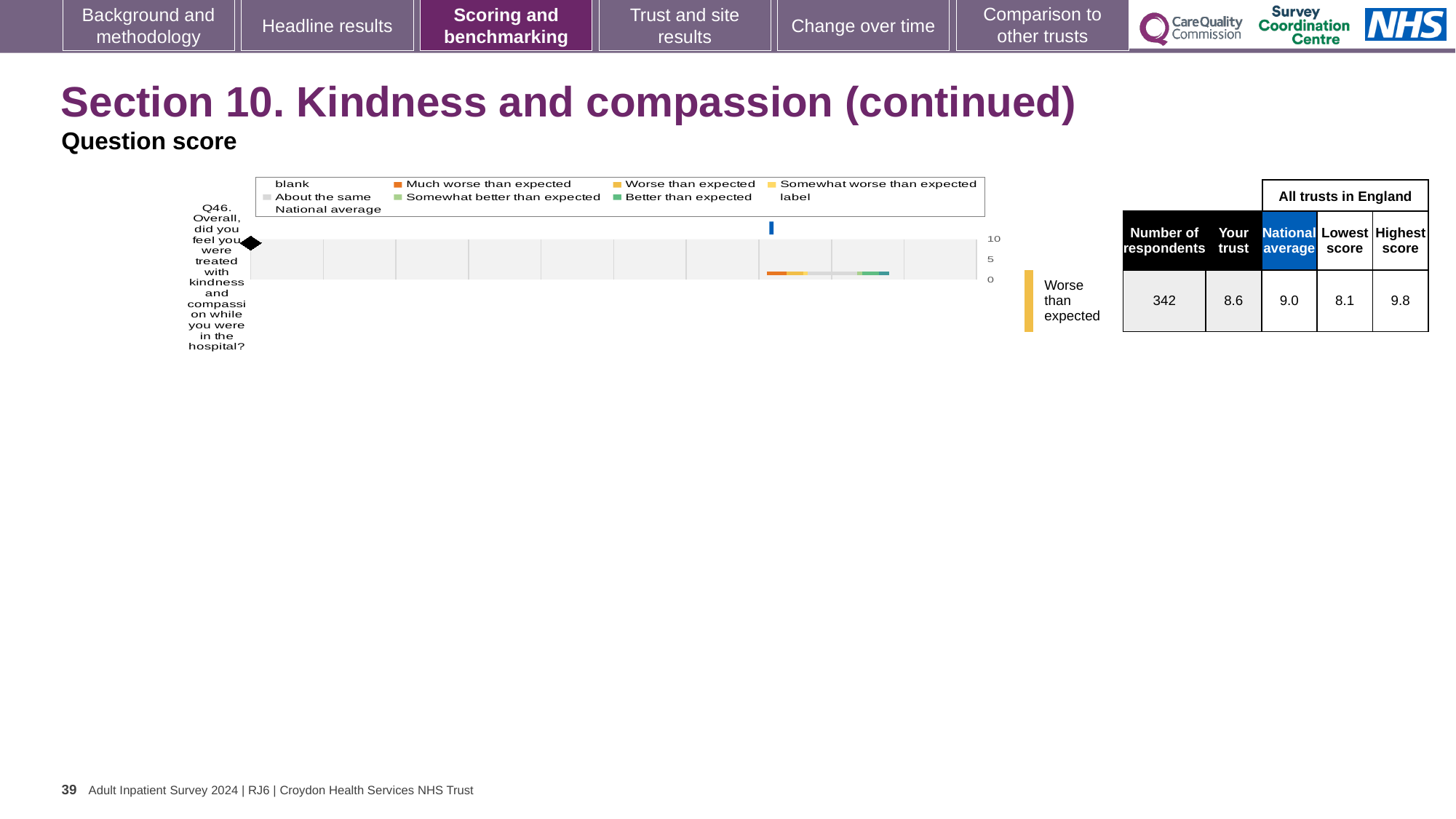
What is the difference between the national average and the trust's score for Q46? 0.4 What is the lowest score among all trusts in England for Q46? 8.1 How many questions (categories) are plotted on the chart? 1 Which is larger for Q46: the trust's score or the national average? National average What is the score for 'Your trust' shown for Q46? 8.6 Which legend entry is shown in the darkest orange colour? Much worse than expected What is the national average score shown for Q46? 9.0 What is the difference between the highest and lowest scores among all trusts in England for Q46? 1.7 What is the highest score among all trusts in England for Q46? 9.8 What kind of chart is shown on the slide? Bar chart How many respondents are shown for Q46? 342 What benchmarking category label is shown next to the chart for Q46? Worse than expected